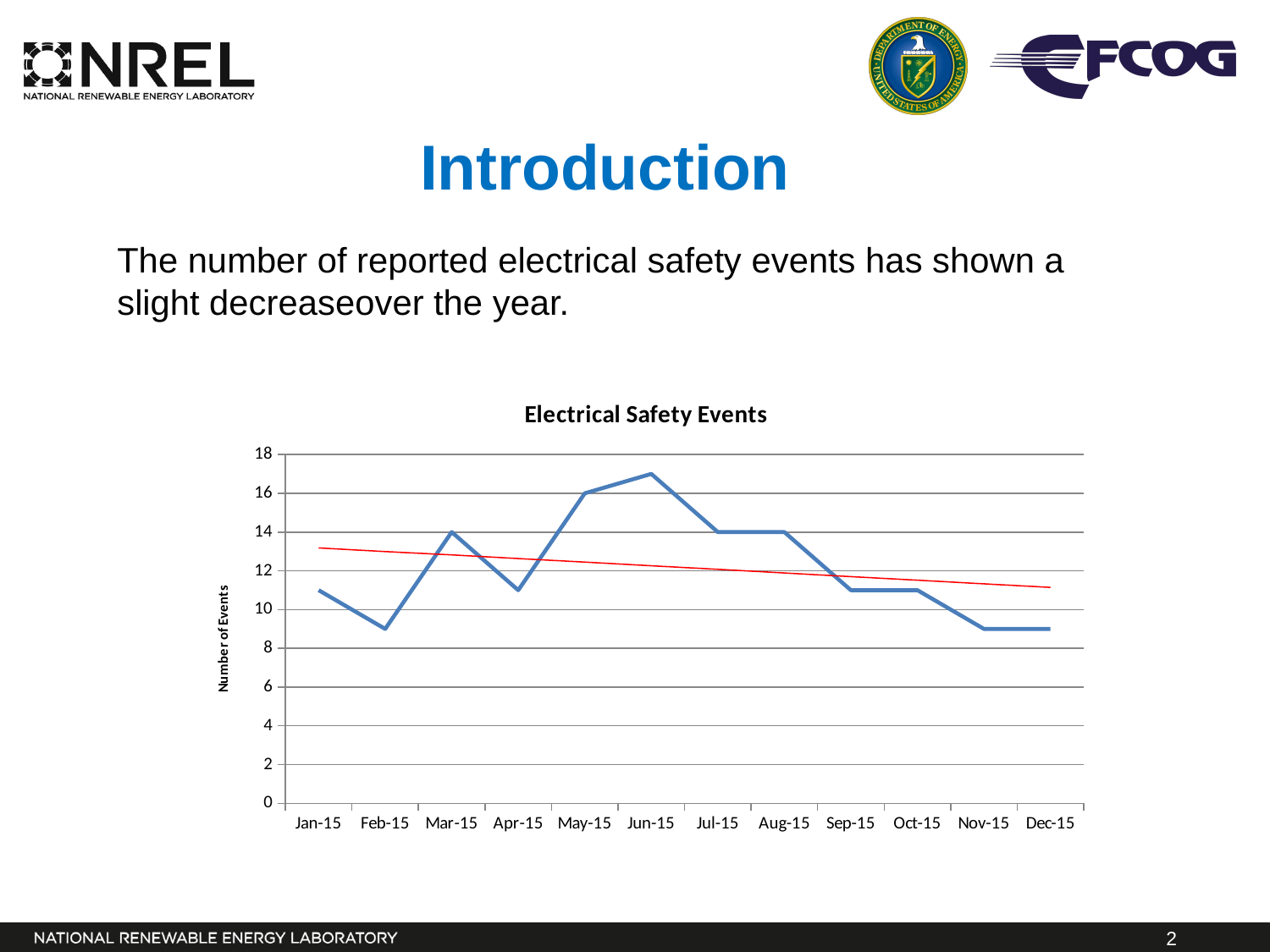
What is the label on the vertical axis of the chart? Number of Events Which is larger, the value for May-15 or the value for Feb-15? May-15 Is the value for Feb-15 greater or less than 10? less Which month has the highest number of events? Jun-15 What type of chart is shown on the slide? Line chart What is the difference between the values for May-15 and Mar-15? 2 How many months are plotted on the x axis of the chart? 12 What is the number of events for Aug-15? 14 What is the number of events for May-15? 16 Is the value for Jun-15 greater or less than 16? greater What is the title of the chart? Electrical Safety Events What is the number of events for Mar-15? 14